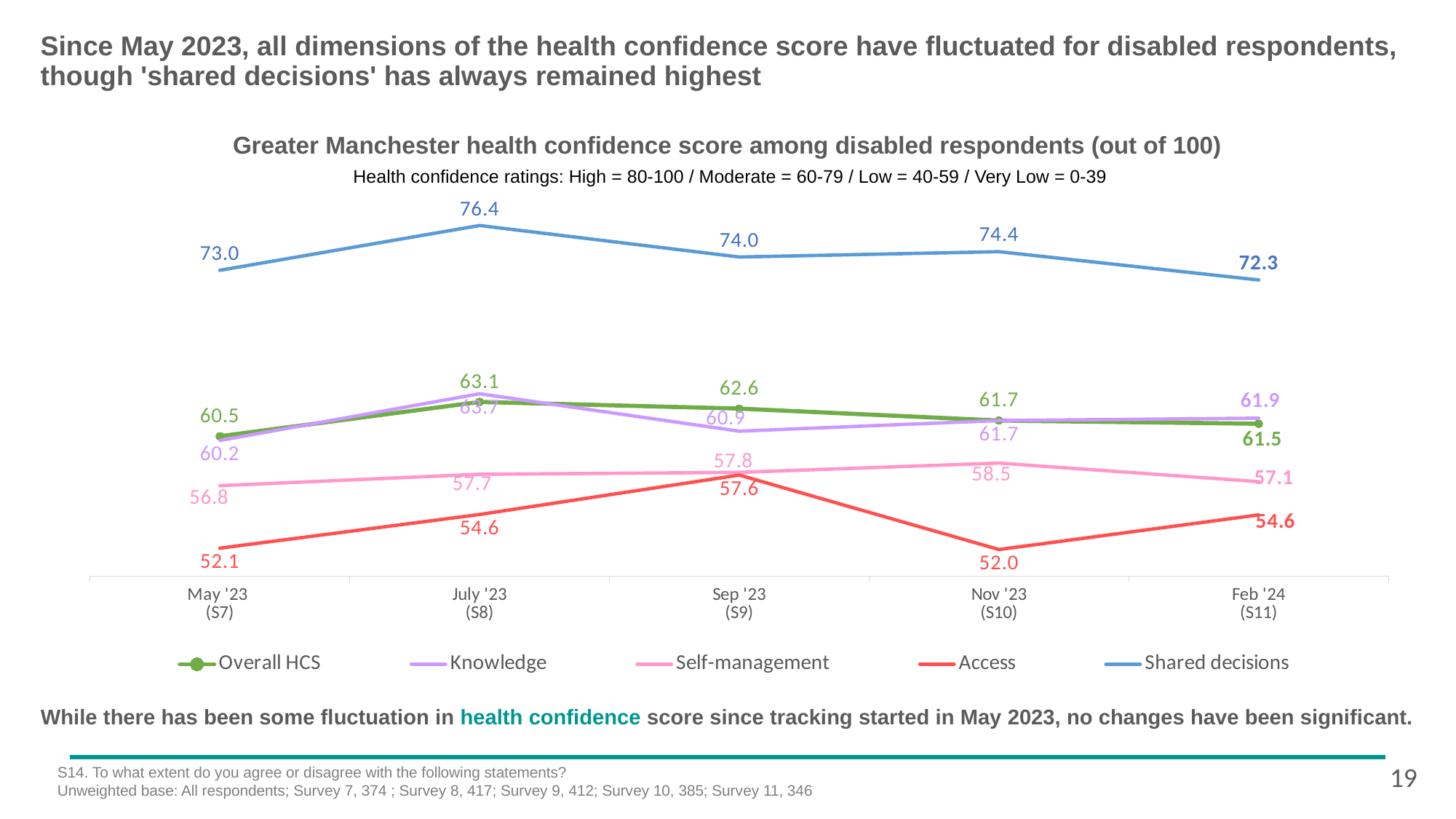
By how much did the Access score rise from May '23 to Sep '23? 5.5 At which time point is the Shared decisions score highest? July '23 (S8) How many series does the legend list? 5 What is the Shared decisions score in July '23 (S8)? 76.4 What is the title of the chart? Greater Manchester health confidence score among disabled respondents (out of 100) What is the difference between the Shared decisions score in July '23 and in Feb '24? 4.1 What is the Overall HCS score in Sep '23 (S9)? 62.6 How many survey time points are plotted along the x axis? 5 What is the Access score in Nov '23 (S10)? 52.0 In Feb '24 (S11), which is higher: the Knowledge score or the Overall HCS score? Knowledge What kind of chart is shown on the slide? Line chart At which time point is the Access score highest? Sep '23 (S9)